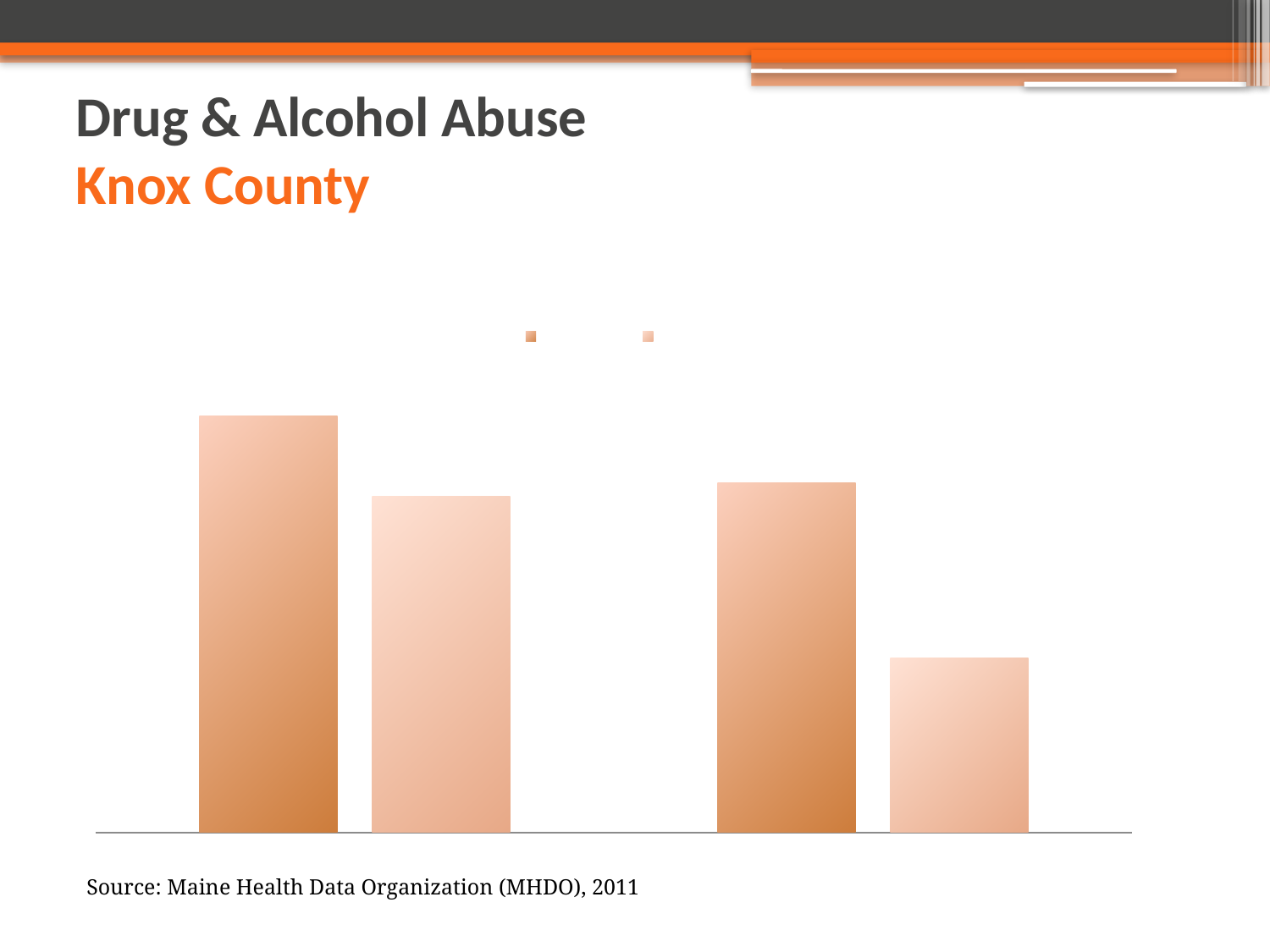
In the left group of bars, is the darker orange bar or the lighter orange bar taller? the darker orange bar How many series does the legend list? 2 In the right group of bars, is the darker orange bar or the lighter orange bar taller? the darker orange bar What is the title of the slide containing the chart? Drug & Alcohol Abuse Knox County Which bar is the tallest in the chart: the leftmost bar or the rightmost bar? the leftmost bar How many bars are plotted in the chart? 4 Which bar is the shortest in the chart: the leftmost bar or the rightmost bar? the rightmost bar What source is cited below the chart? Maine Health Data Organization (MHDO), 2011 What kind of chart is shown on the slide? bar chart Is the lighter bar in the left group taller or shorter than the lighter bar in the right group? taller How many groups of bars does the chart show? 2